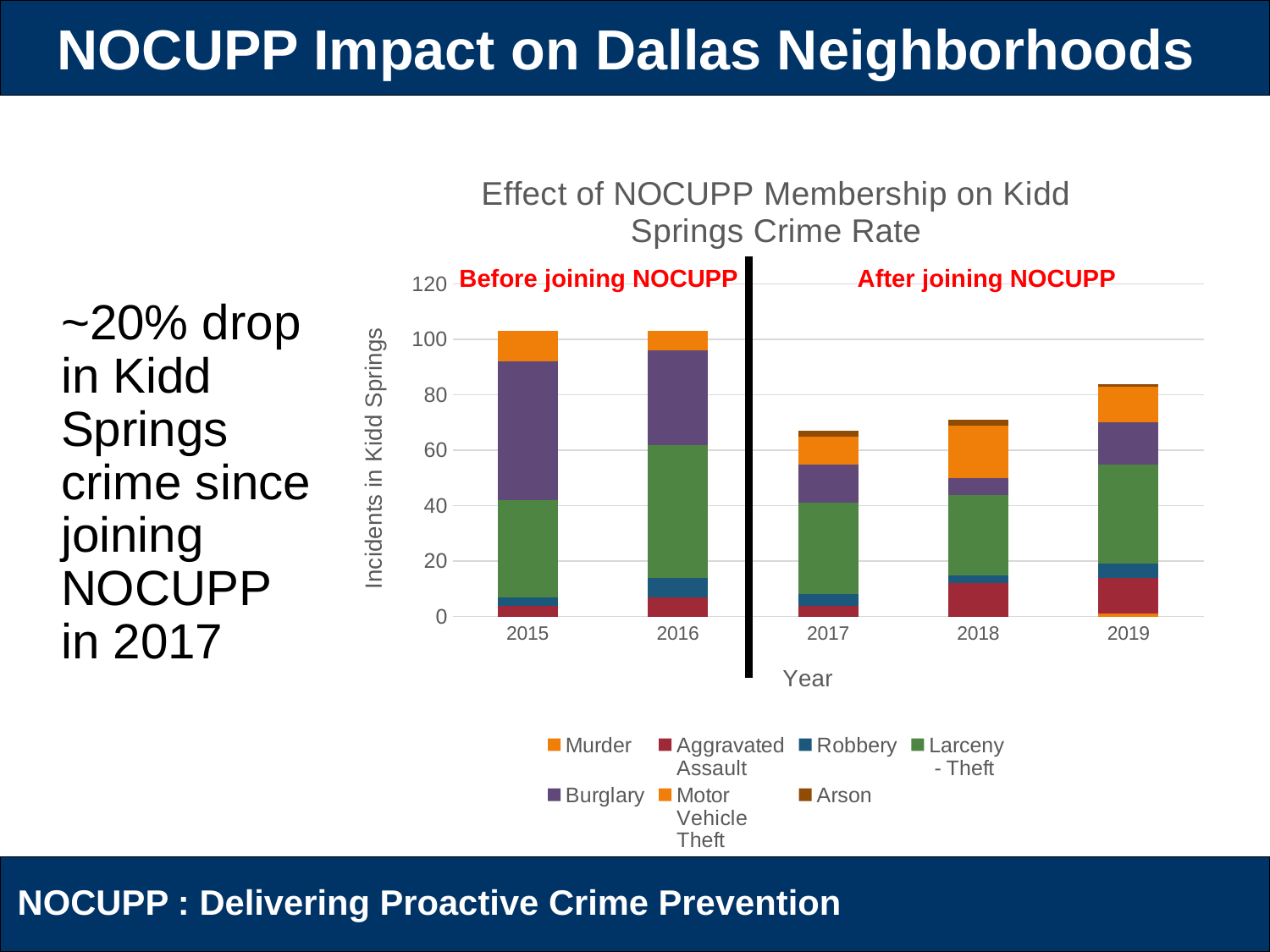
Which year has a higher total of incidents, 2016 or 2019? 2016 Do total incidents rise or fall from 2016 to 2017? fall How many series does the chart's legend list? 7 What is the label on the chart's y axis? Incidents in Kidd Springs What kind of chart is shown on the slide? Stacked bar chart Is the total number of incidents for 2015 greater or less than 80? greater Is the total number of incidents for 2019 greater or less than 100? less Is the total number of incidents for 2018 greater or less than 80? less What is the title of the chart? Effect of NOCUPP Membership on Kidd Springs Crime Rate Which year has a higher total of incidents, 2017 or 2019? 2019 How many years are shown on the x axis of the chart? 5